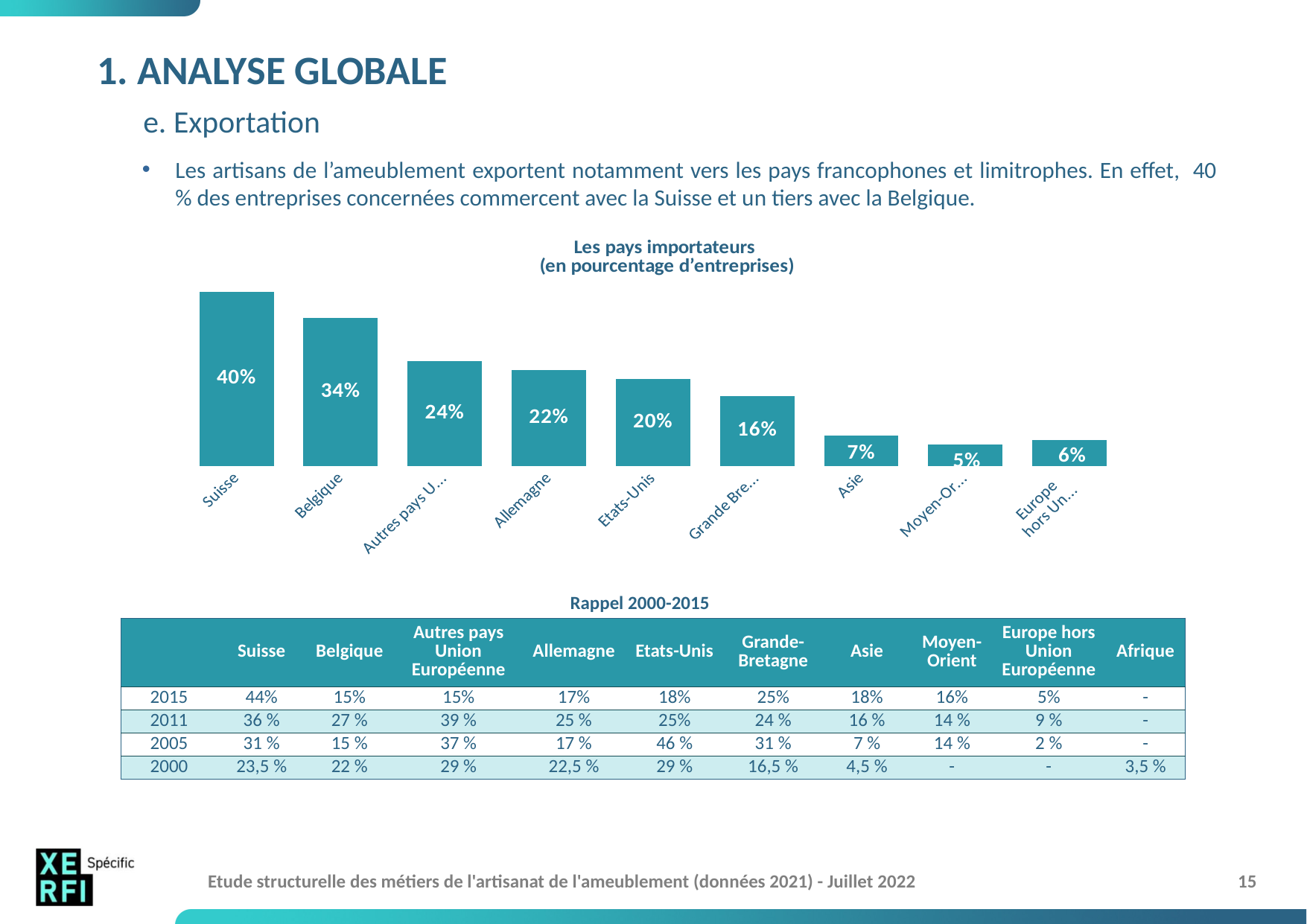
What is the value for Belgique in the chart? 34% What is the difference between the values for Suisse and Belgique? 6% What is the value for Allemagne in the chart? 22% Which is larger, the value for Allemagne or the value for Etats-Unis? Allemagne What is the title of the chart? Les pays importateurs (en pourcentage d'entreprises) What kind of chart is shown on the slide? Bar chart Do the bar values generally rise or fall from left to right across the chart? Fall What is the value for Etats-Unis in the chart? 20% How many categories (bars) are shown in the chart? 9 What is the value for Asie in the chart? 7% What is the value for Suisse in the chart? 40% Which category has the highest value in the chart? Suisse